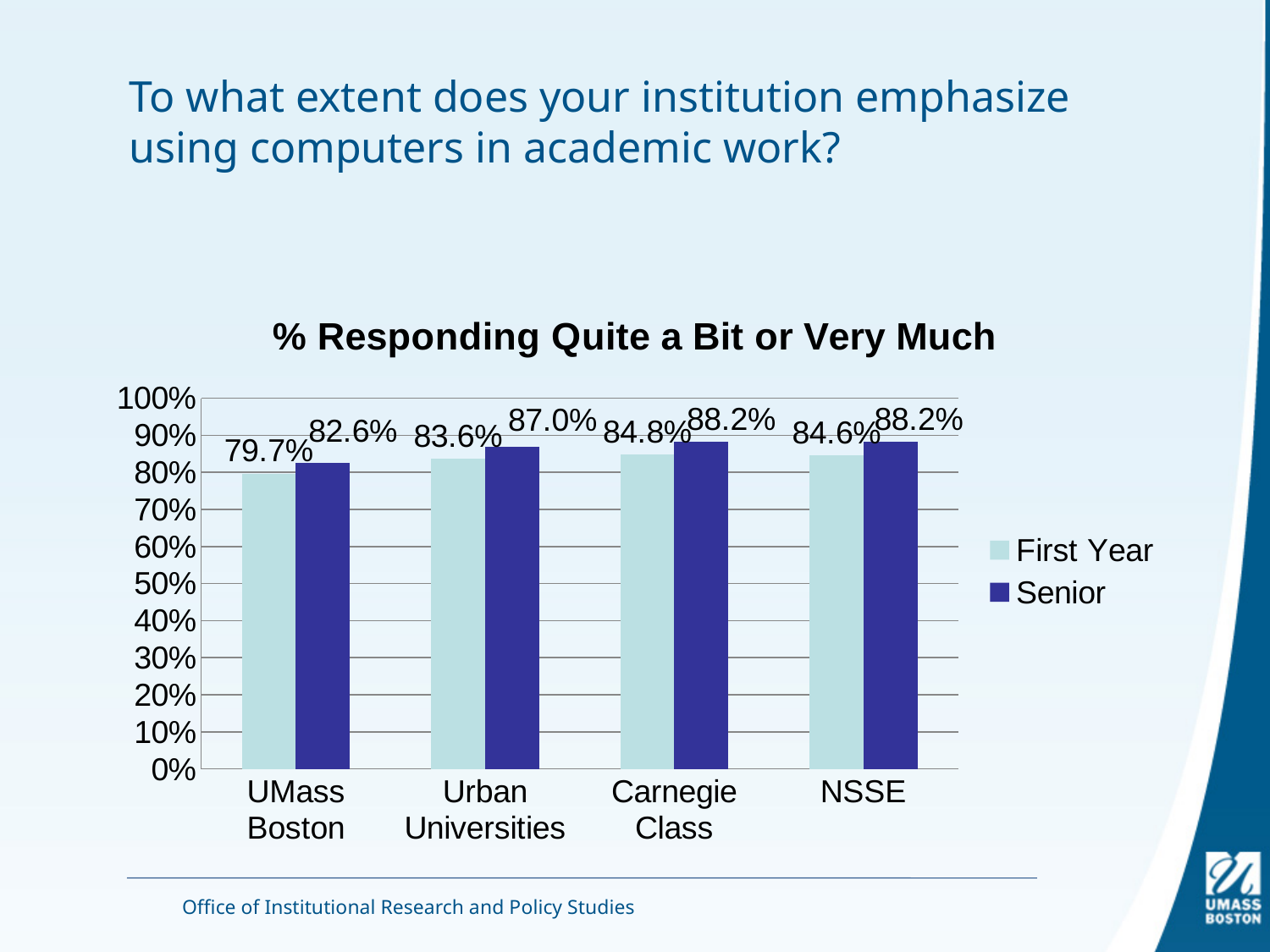
What is the Senior value for NSSE? 88.2% What is the First Year value for UMass Boston? 79.7% What is the First Year value for Carnegie Class? 84.8% Is the First Year value for UMass Boston greater or less than 80%? less What is the Senior value for Urban Universities? 87.0% How many categories are shown on the x axis? 4 Which category has the highest First Year value? Carnegie Class What is the difference between the Senior and First Year values for UMass Boston? 2.9% What kind of chart is shown on the slide? bar chart Which is larger for Urban Universities, the First Year value or the Senior value? Senior How many series does the legend list? 2 Which category has the lowest First Year value? UMass Boston